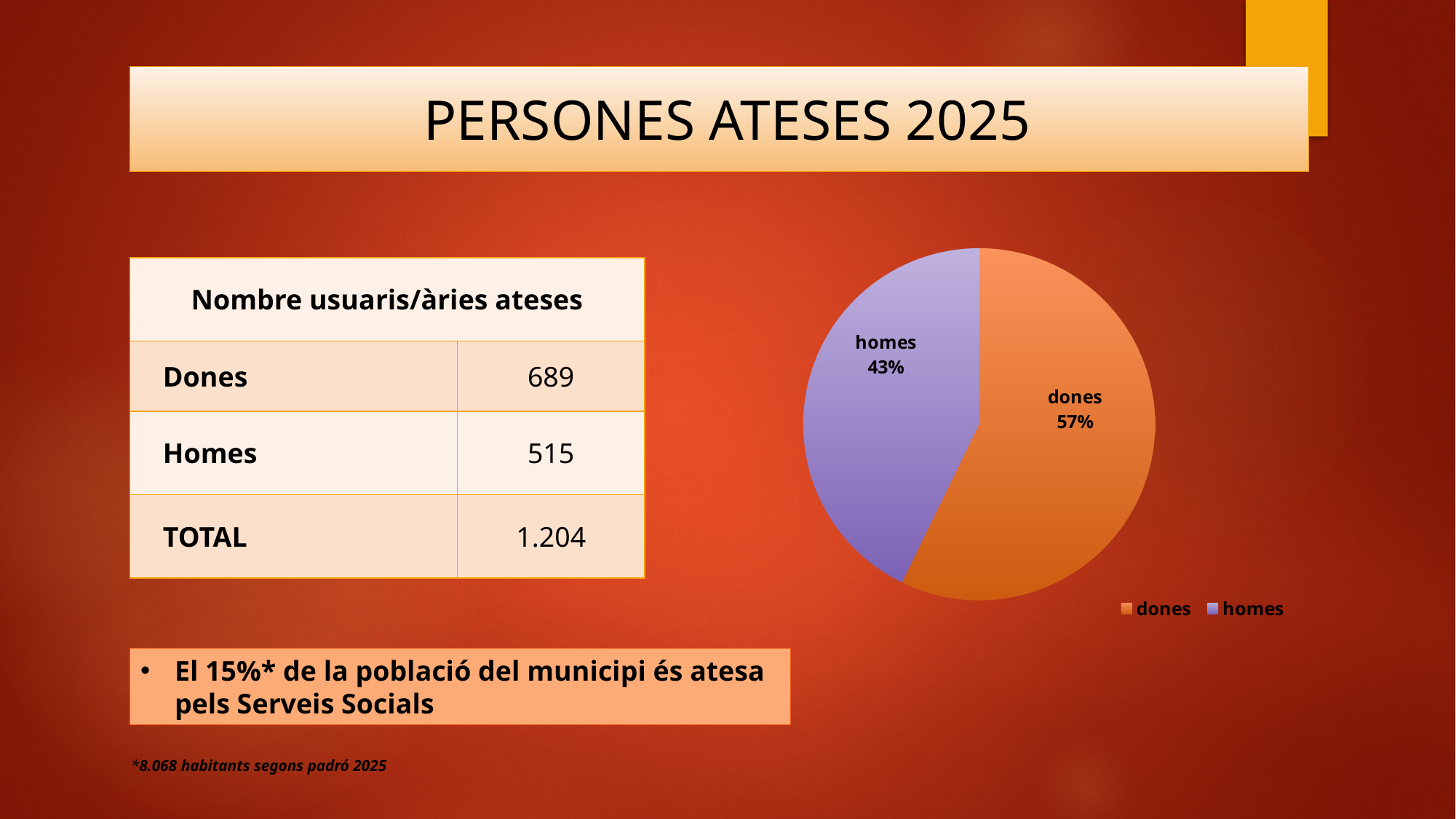
What share of the pie does the "dones" slice represent? 57% What colour is the "homes" slice in the pie chart? purple What colour is the "dones" slice in the pie chart? orange What is the difference in percentage points between the "dones" and "homes" slices? 14 Which slice is larger, "dones" or "homes"? dones How many entries does the legend of the pie chart list? 2 Which slice of the pie chart is the smallest? homes How many slices does the pie chart have? 2 Which slice of the pie chart is the largest? dones What share of the pie does the "homes" slice represent? 43% What kind of chart is shown on the slide? pie chart